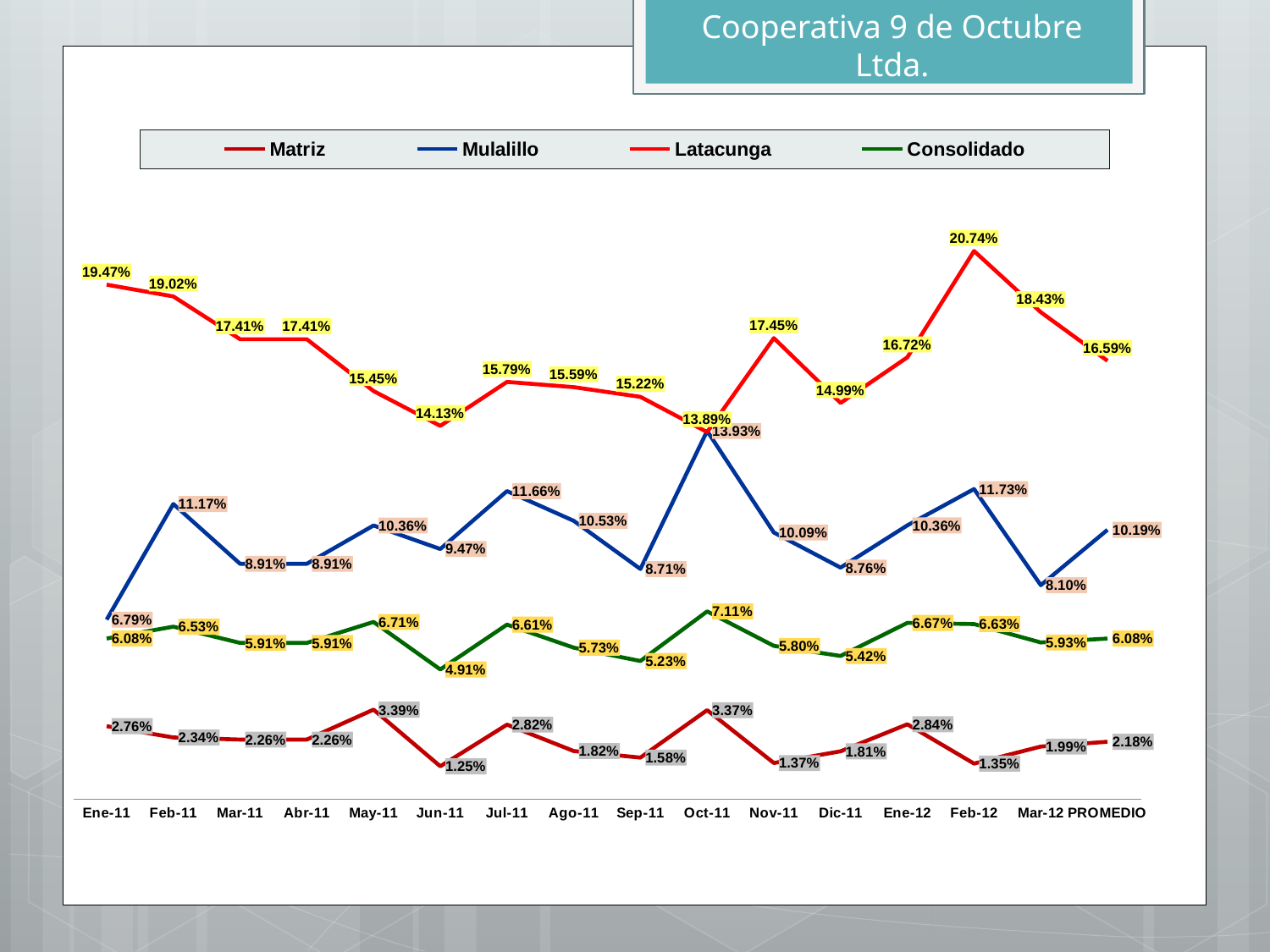
What is the value for Consolidado in Jun-11? 4.91% What type of chart is shown on the slide? Line chart Which is larger, the Mulalillo value in Feb-11 or in Feb-12? Feb-12 What is the value for Mulalillo in Oct-11? 13.93% Which series is drawn in green in the legend? Consolidado In which month does Latacunga reach its highest value? Feb-12 How many categories are shown along the x axis? 16 How many series does the legend list? 4 What is the PROMEDIO value for Matriz? 2.18% What is the difference between the Latacunga values in Ene-11 and Mar-12? 1.04% What is the value for Latacunga in Feb-12? 20.74% In which month does Matriz have its lowest value? Jun-11